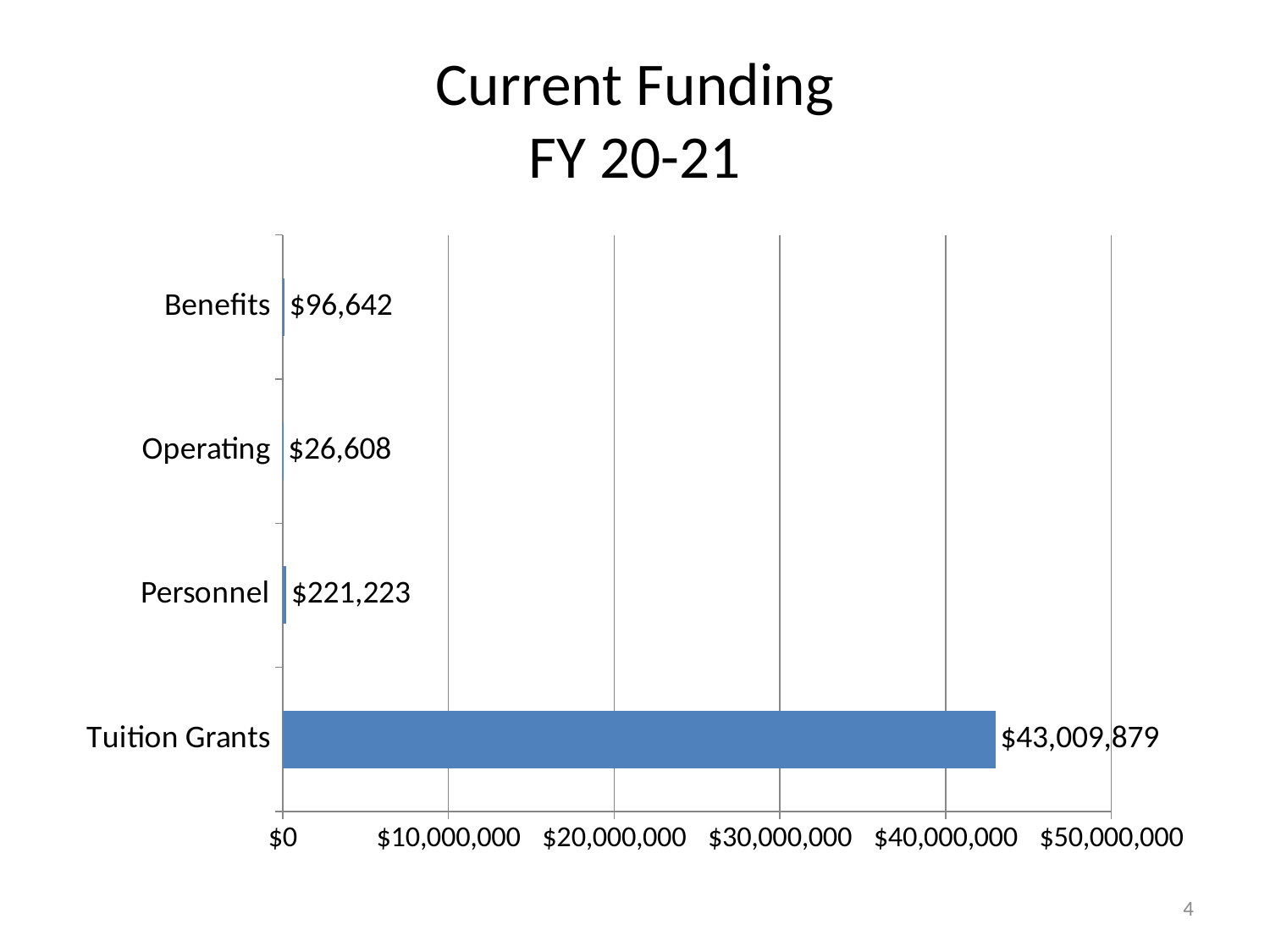
Which category has the lowest value? Operating What is the value for Personnel? $221,223 What kind of chart is shown on the slide? bar chart What is the value for Benefits? $96,642 What is the title of the chart? Current Funding FY 20-21 How many categories are shown in the chart? 4 Is the value for Tuition Grants greater or less than $40,000,000? greater What is the value for Operating? $26,608 Which category has the highest value? Tuition Grants What is the value for Tuition Grants? $43,009,879 What is the difference between the Personnel and Benefits values? $124,581 Which is larger, the value for Benefits or the value for Operating? Benefits